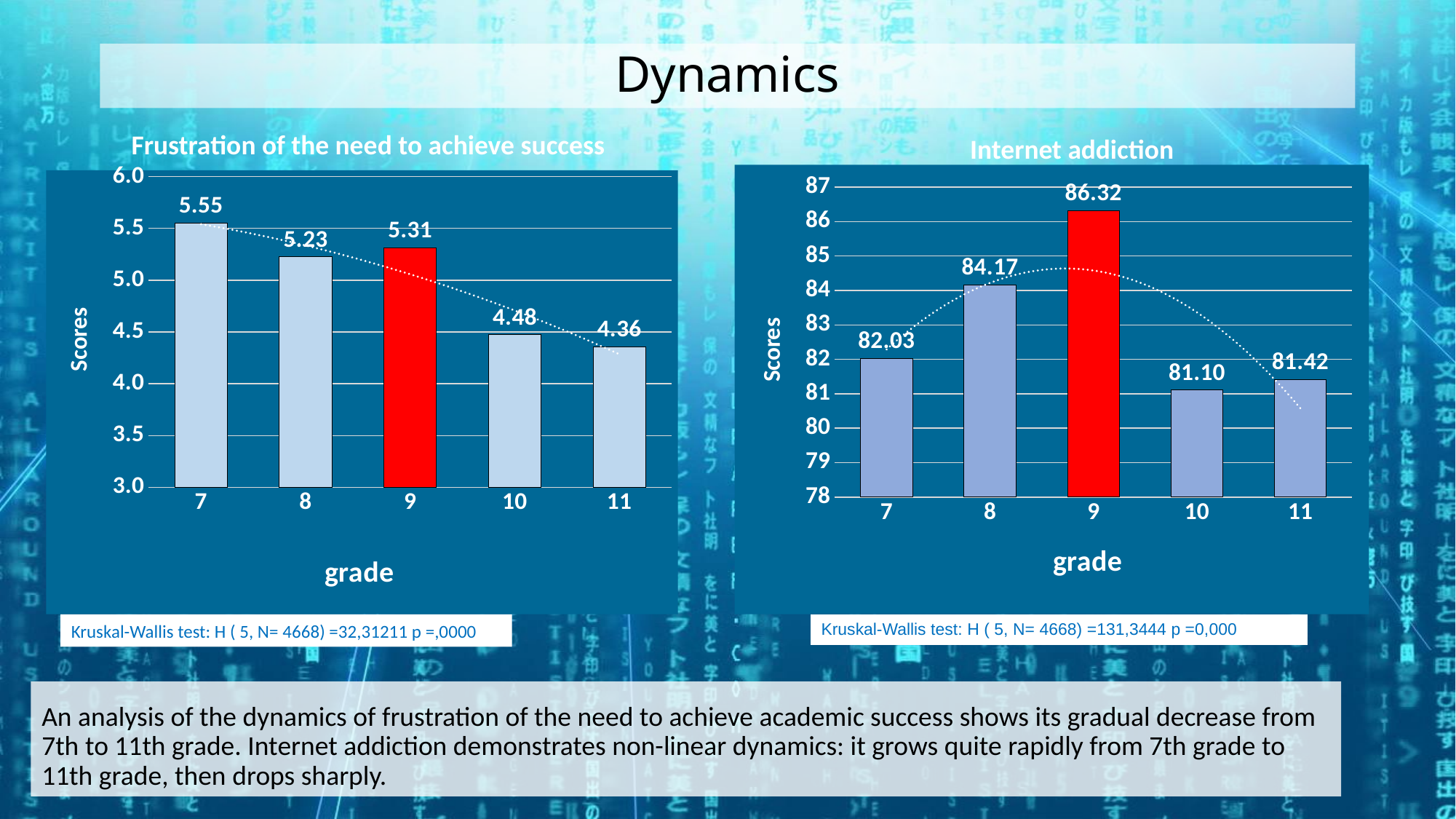
In the 'Internet addiction' chart, which grade has the highest score? 9 In the 'Internet addiction' chart, which grade has a higher score, grade 7 or grade 11? 7 In the 'Internet addiction' chart, what is the difference between the scores for grade 9 and grade 8? 2.15 In the 'Internet addiction' chart, what is the score for grade 9? 86.32 In the 'Frustration of the need to achieve success' chart, what is the difference between the scores for grade 7 and grade 11? 1.19 In the 'Frustration of the need to achieve success' chart, what is the score for grade 7? 5.55 How many grade categories are shown in the 'Frustration of the need to achieve success' chart? 5 In the 'Frustration of the need to achieve success' chart, do the scores generally rise or fall from grade 7 to grade 11? fall What type of chart is the 'Internet addiction' chart? bar chart In the 'Frustration of the need to achieve success' chart, which grade has a higher score, grade 8 or grade 9? 9 In the 'Internet addiction' chart, which grade has the lowest score? 10 In the 'Frustration of the need to achieve success' chart, which grade has the lowest score? 11